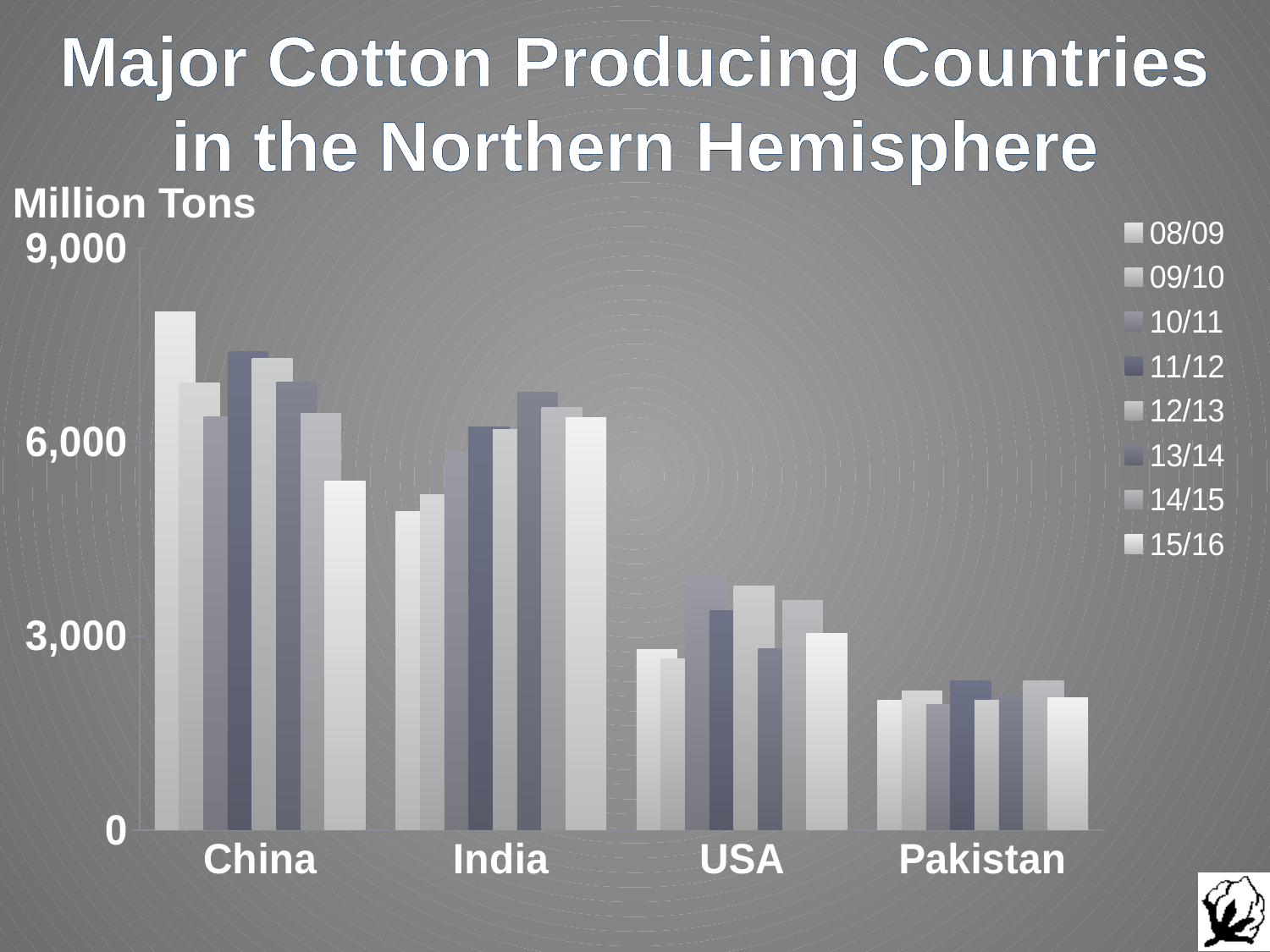
Which country has the highest value for the 08/09 season? China How many series does the legend list? 8 Which is larger, the 15/16 value for USA or the 15/16 value for Pakistan? USA Which country has the lowest cotton production across all seasons shown? Pakistan How many countries are shown on the x axis? 4 Is the value for India in 08/09 greater or less than 6,000? less For China, which season has the highest value? 08/09 What kind of chart is shown on the slide? bar chart For China, which season has the lowest value? 15/16 What unit is given for the y axis? Million Tons Is the value for China in 08/09 greater or less than 6,000? greater Is the value for Pakistan in 15/16 greater or less than 3,000? less